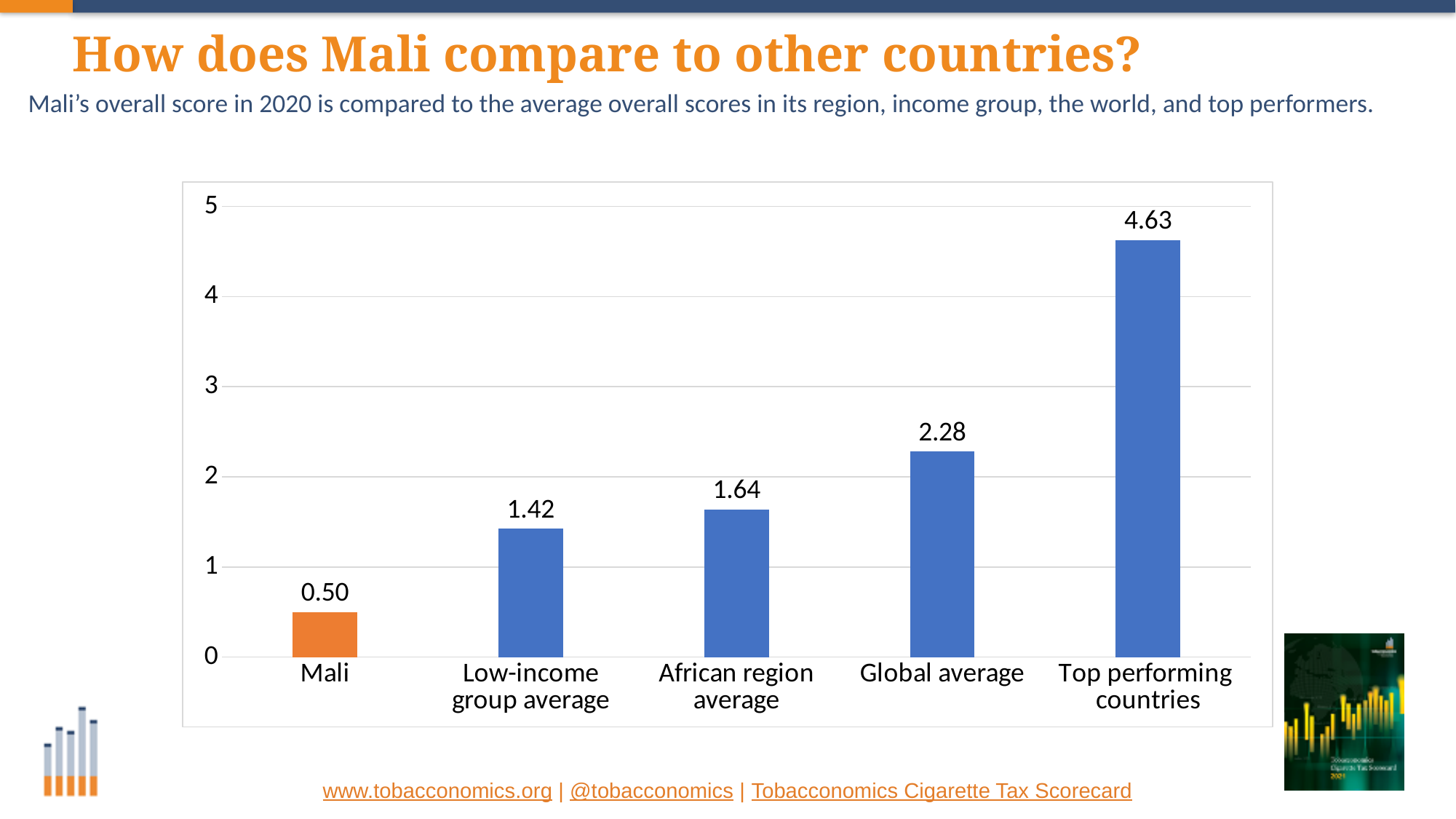
How many categories are shown on the chart? 5 What is the value shown for Top performing countries? 4.63 Which is larger, the Low-income group average or the African region average? African region average What is the value shown for the Global average? 2.28 Which category has the lowest value? Mali What is the difference between the Global average and the African region average? 0.64 What is the difference between the Top performing countries value and Mali's value? 4.13 Which category has the highest value? Top performing countries What is the value shown for the Low-income group average? 1.42 What is the value shown for Mali? 0.50 What is the value shown for the African region average? 1.64 What kind of chart is shown on the slide? Bar chart